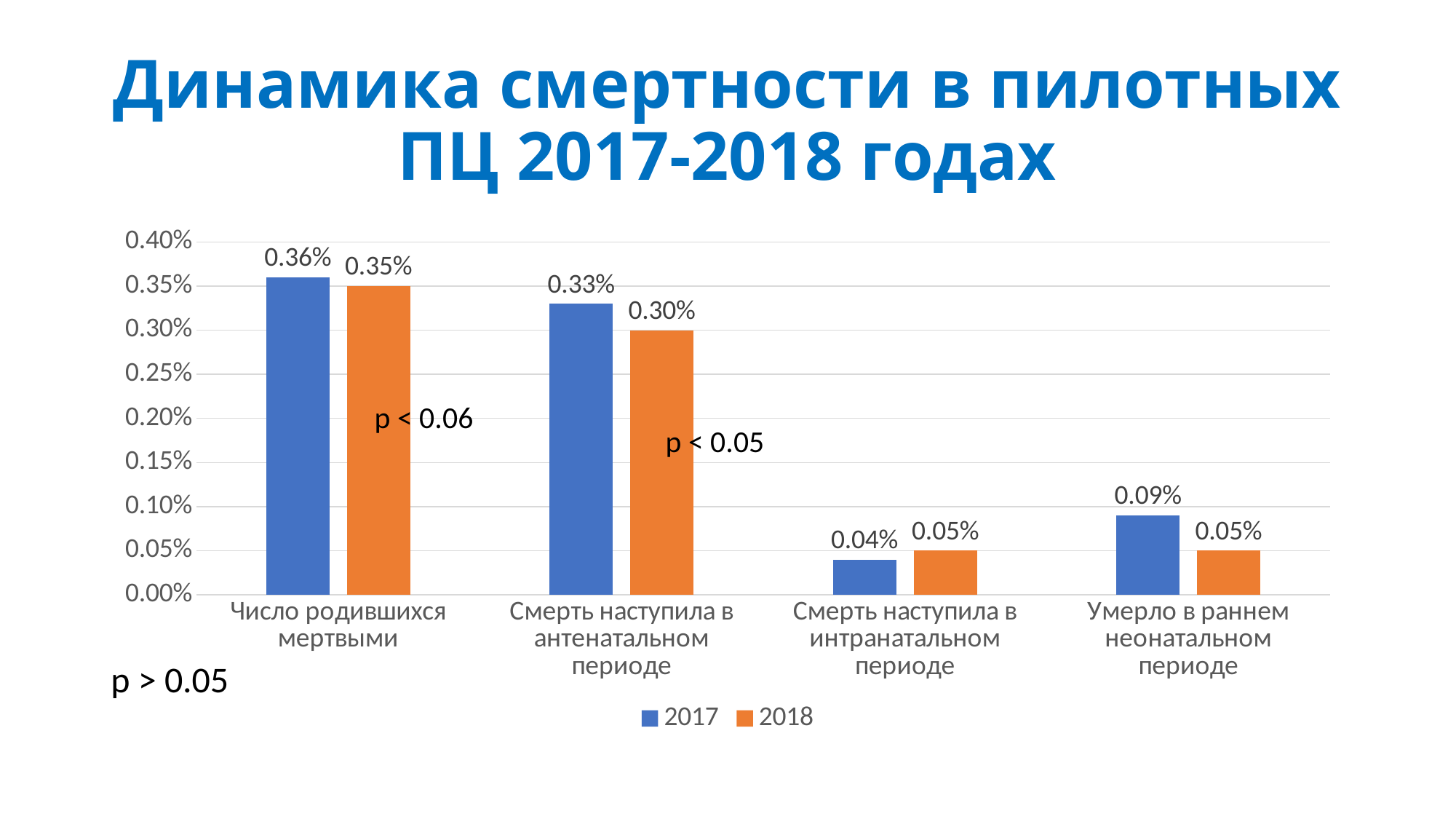
How many series does the legend list? 2 What is the 2017 value for "Число родившихся мертвыми"? 0.36% What type of chart is shown on the slide? Bar chart What is the 2018 value for "Смерть наступила в антенатальном периоде"? 0.30% What is the 2018 value for "Смерть наступила в интранатальном периоде"? 0.05% Which colour represents the 2018 series? Orange For "Умерло в раннем неонатальном периоде", which year has the larger value, 2017 or 2018? 2017 Which category has the highest 2017 value? Число родившихся мертвыми Which category has the lowest 2017 value? Смерть наступила в интранатальном периоде What is the 2017 value for "Умерло в раннем неонатальном периоде"? 0.09% How many categories are shown on the x axis? 4 What is the difference between the 2017 and 2018 values for "Смерть наступила в антенатальном периоде"? 0.03%